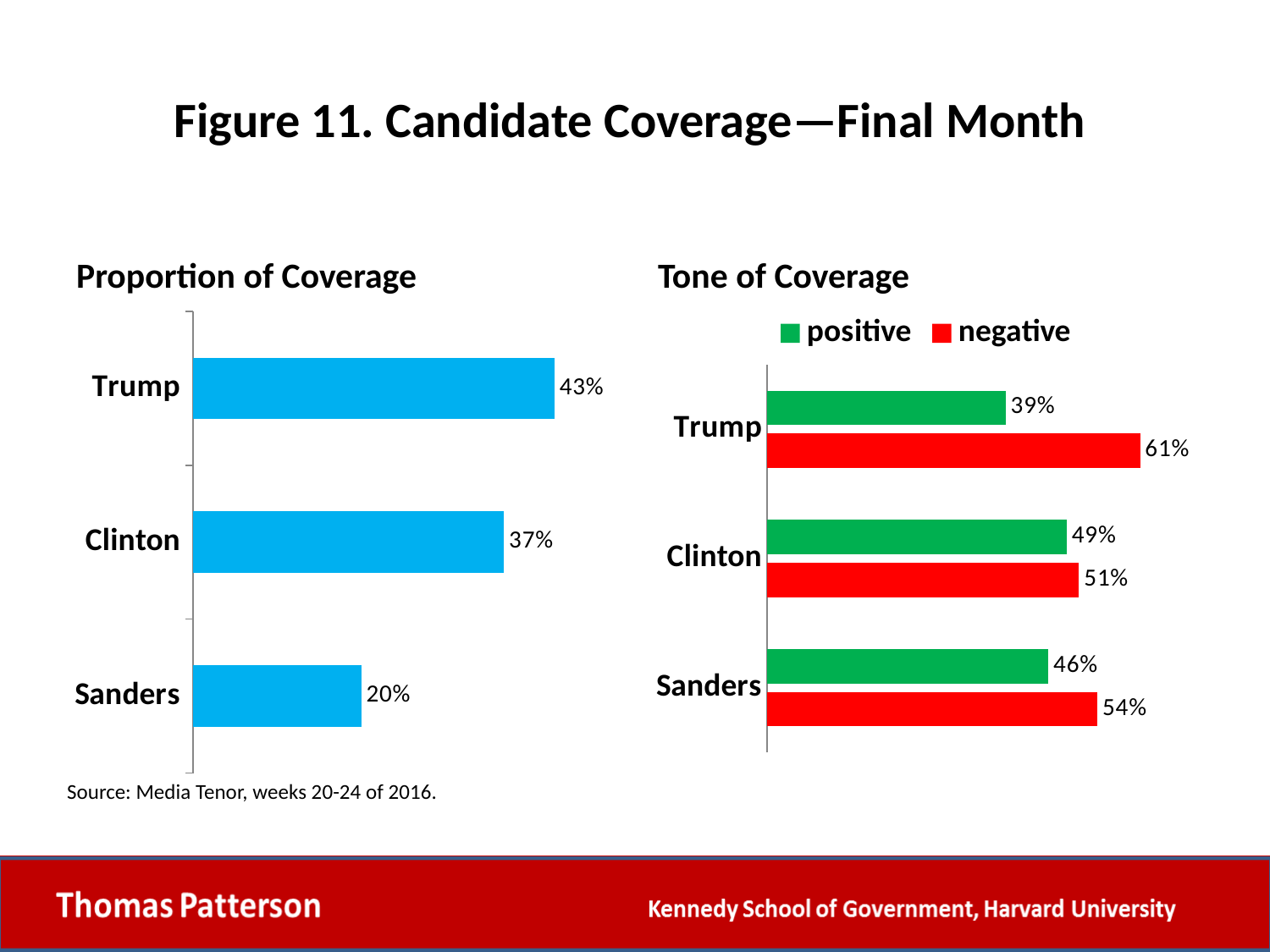
In the Proportion of Coverage chart, what is the value for Trump? 43% In the Tone of Coverage chart, what is the negative value for Trump? 61% What kind of chart is the Proportion of Coverage chart? Bar chart In the Tone of Coverage chart, how many series does the legend list? 2 In the Proportion of Coverage chart, what is the difference between Trump's and Clinton's values? 6% In the Tone of Coverage chart, is Clinton's positive value or negative value larger? negative In the Proportion of Coverage chart, how many candidates are shown? 3 In the Tone of Coverage chart, what is the positive value for Sanders? 46% In the Proportion of Coverage chart, which candidate has the lowest proportion of coverage? Sanders In the Tone of Coverage chart, what is the difference between Trump's negative and positive values? 22% In the Tone of Coverage chart, what colour represents the negative series? Red In the Tone of Coverage chart, which candidate has the highest positive value? Clinton